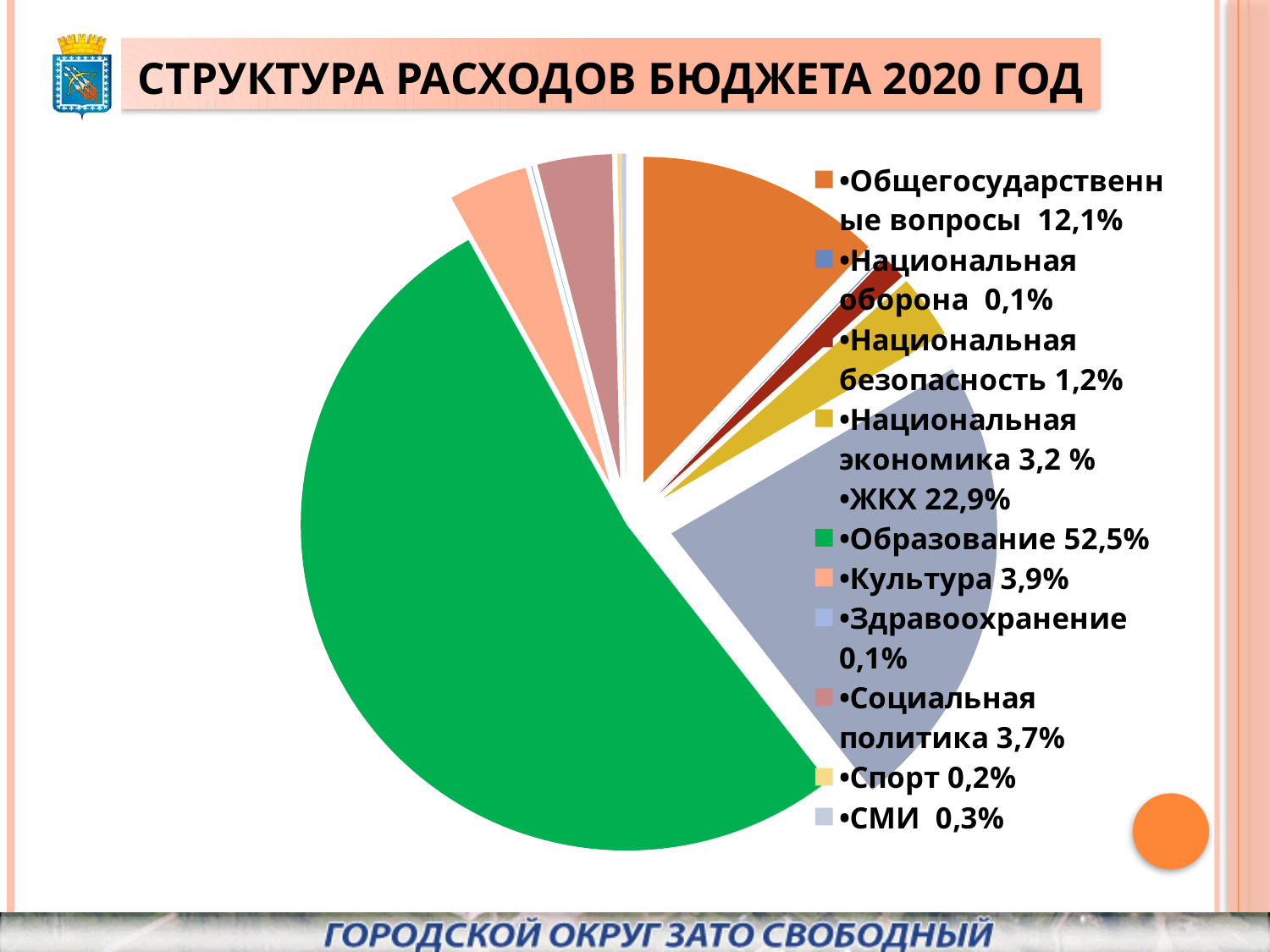
What is the title of the chart on the slide? СТРУКТУРА РАСХОДОВ БЮДЖЕТА 2020 ГОД Which category has the largest share of the pie? Образование What is the value shown for Социальная политика? 3,7% How many categories does the legend list? 11 What is the value shown for ЖКХ? 22,9% What is the value shown for Спорт? 0,2% What is the value shown for Общегосударственные вопросы? 12,1% What is the value shown for Культура? 3,9% What is the difference between the shares of Образование and ЖКХ? 29,6% What share of the budget expenditure goes to Образование? 52,5% Which is larger, the share for ЖКХ or the share for Общегосударственные вопросы? ЖКХ What kind of chart is shown on the slide? Pie chart